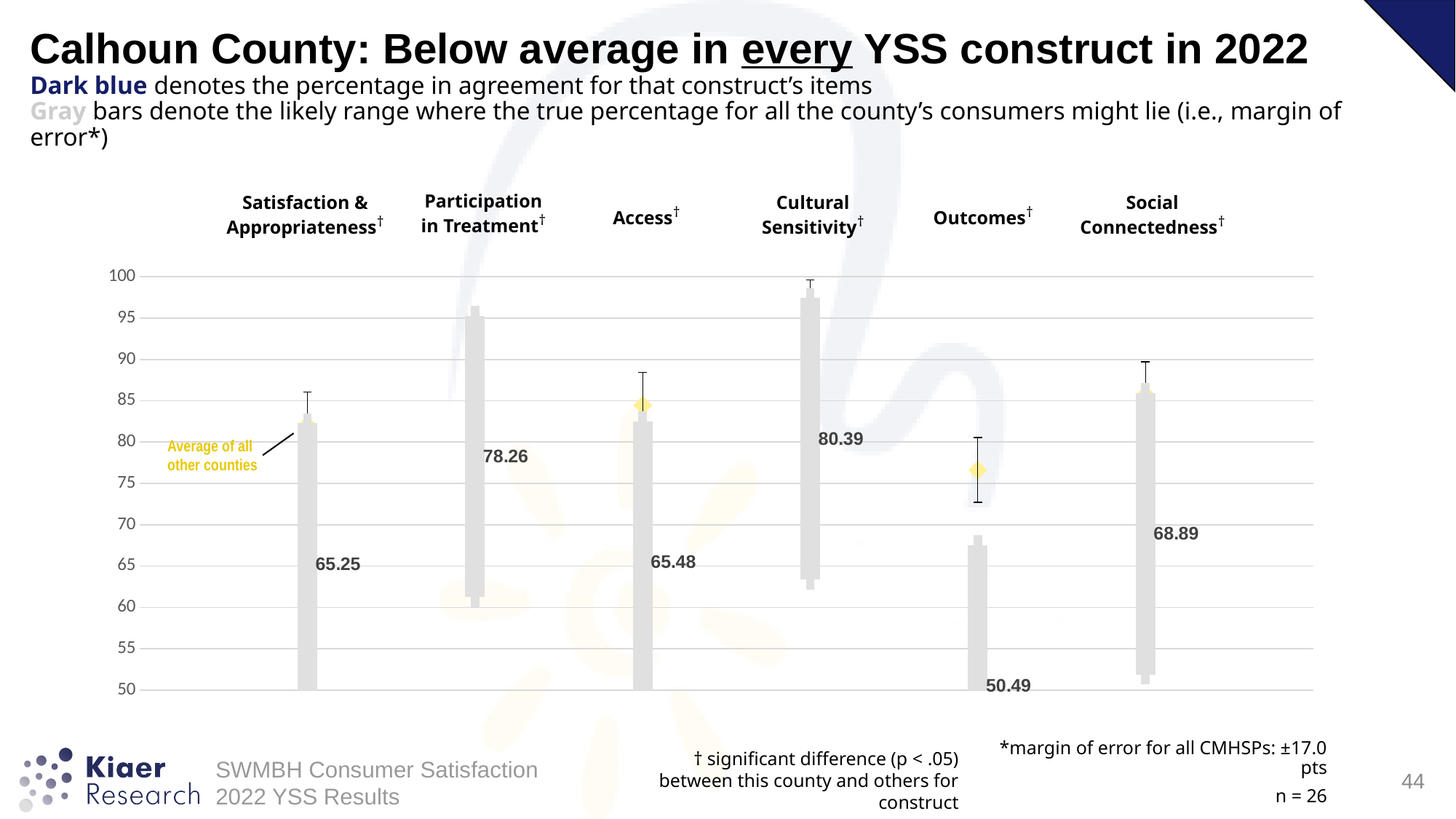
What is the difference between the values for Cultural Sensitivity and Outcomes? 29.90 What is the value for Satisfaction & Appropriateness? 65.25 What does the yellow diamond marker on the chart denote? Average of all other counties What is the value for Outcomes? 50.49 What is the value for Participation in Treatment? 78.26 Which construct has the lowest labeled value? Outcomes What is the value for Social Connectedness? 68.89 Which is larger, the value for Participation in Treatment or the value for Social Connectedness? Participation in Treatment Which construct has the highest labeled value? Cultural Sensitivity What is the value for Cultural Sensitivity? 80.39 Is the 'Average of all other counties' marker for Access greater or less than 80? greater How many constructs are shown on the chart? 6